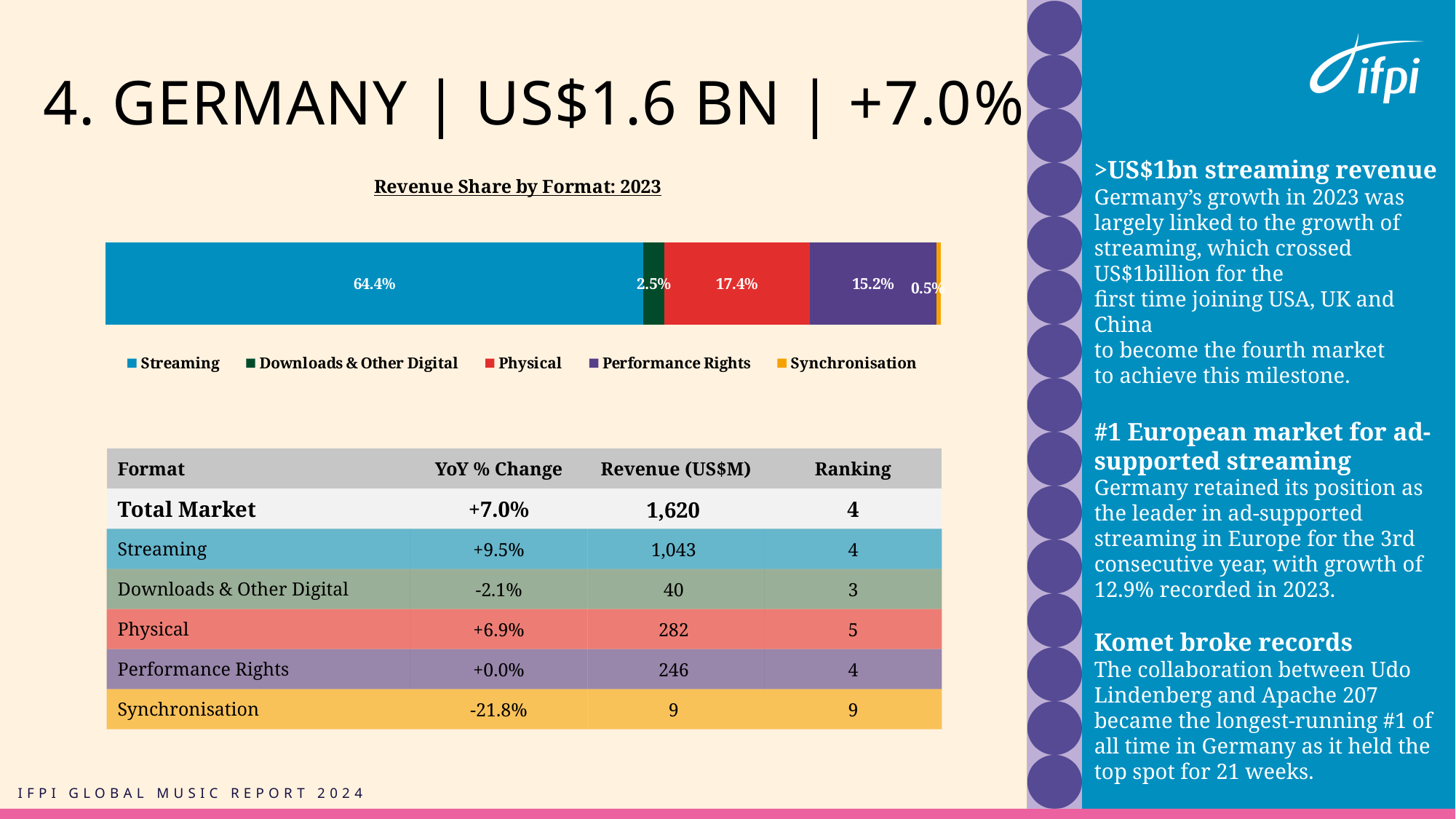
Which has a larger revenue share in the chart, Physical or Performance Rights? Physical What is the title of the chart? Revenue Share by Format: 2023 What type of chart is shown on the slide? Stacked bar chart What share of revenue does Streaming account for in the chart? 64.4% Which format has the largest revenue share in the chart? Streaming What is the difference in revenue share between Physical and Performance Rights in the chart? 2.2% What share of revenue does Synchronisation account for in the chart? 0.5% How many formats does the chart legend list? 5 What share of revenue does Performance Rights account for in the chart? 15.2% What share of revenue does Physical account for in the chart? 17.4% Which format has the smallest revenue share in the chart? Synchronisation What share of revenue does Downloads & Other Digital account for in the chart? 2.5%